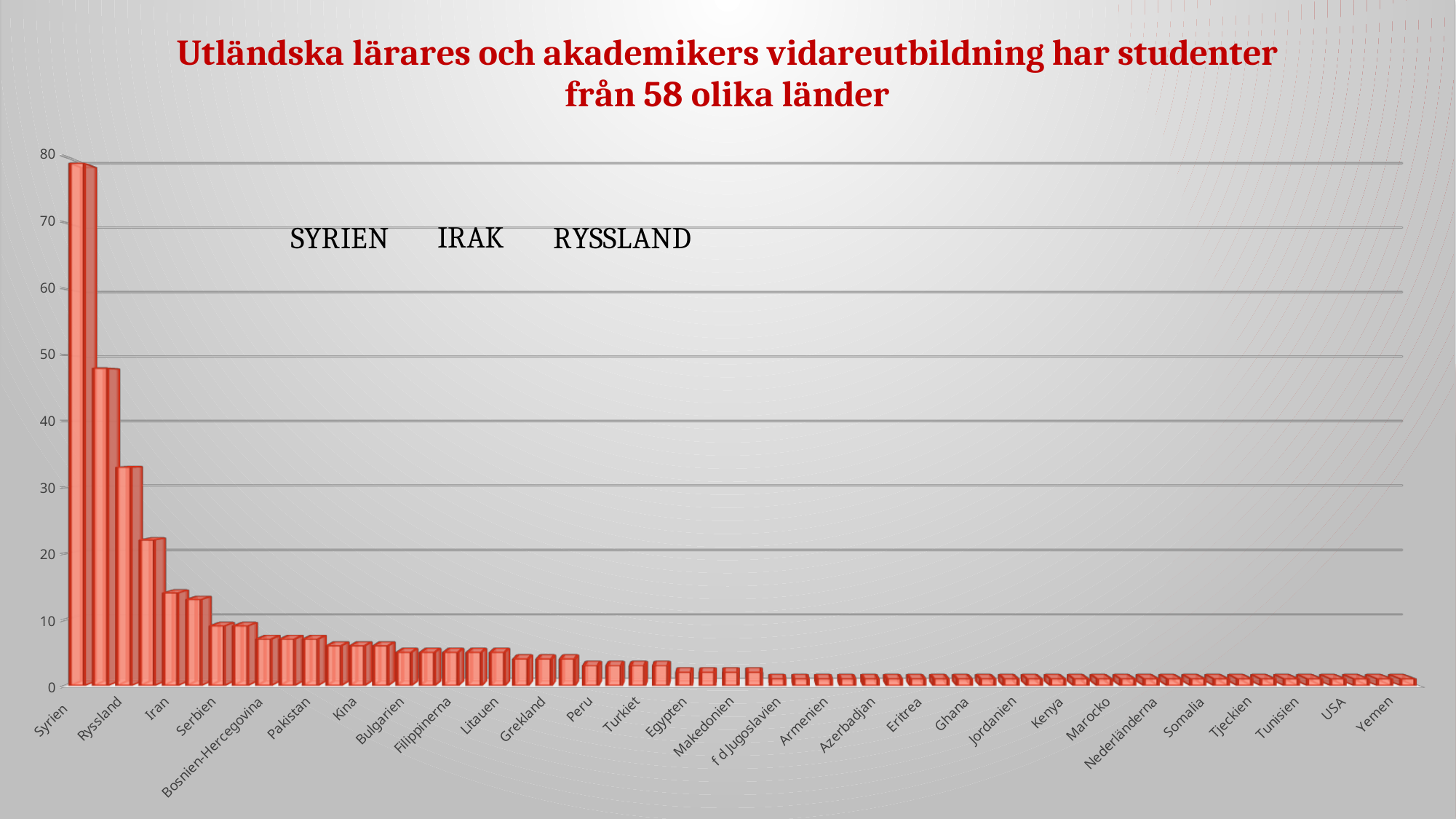
According to the slide title, from how many different countries do the students come? 58 Is the value for Syrien greater or less than 70? greater What kind of chart is shown on the slide? bar chart Is the value for Yemen greater or less than 10? less Which country has the highest bar in the chart? Syrien Is the value for Ryssland greater or less than 40? less Which has the larger value, Iran or Serbien? Iran Do the bar values rise or fall from left to right along the x axis? fall Which has the larger value, Syrien or Ryssland? Syrien